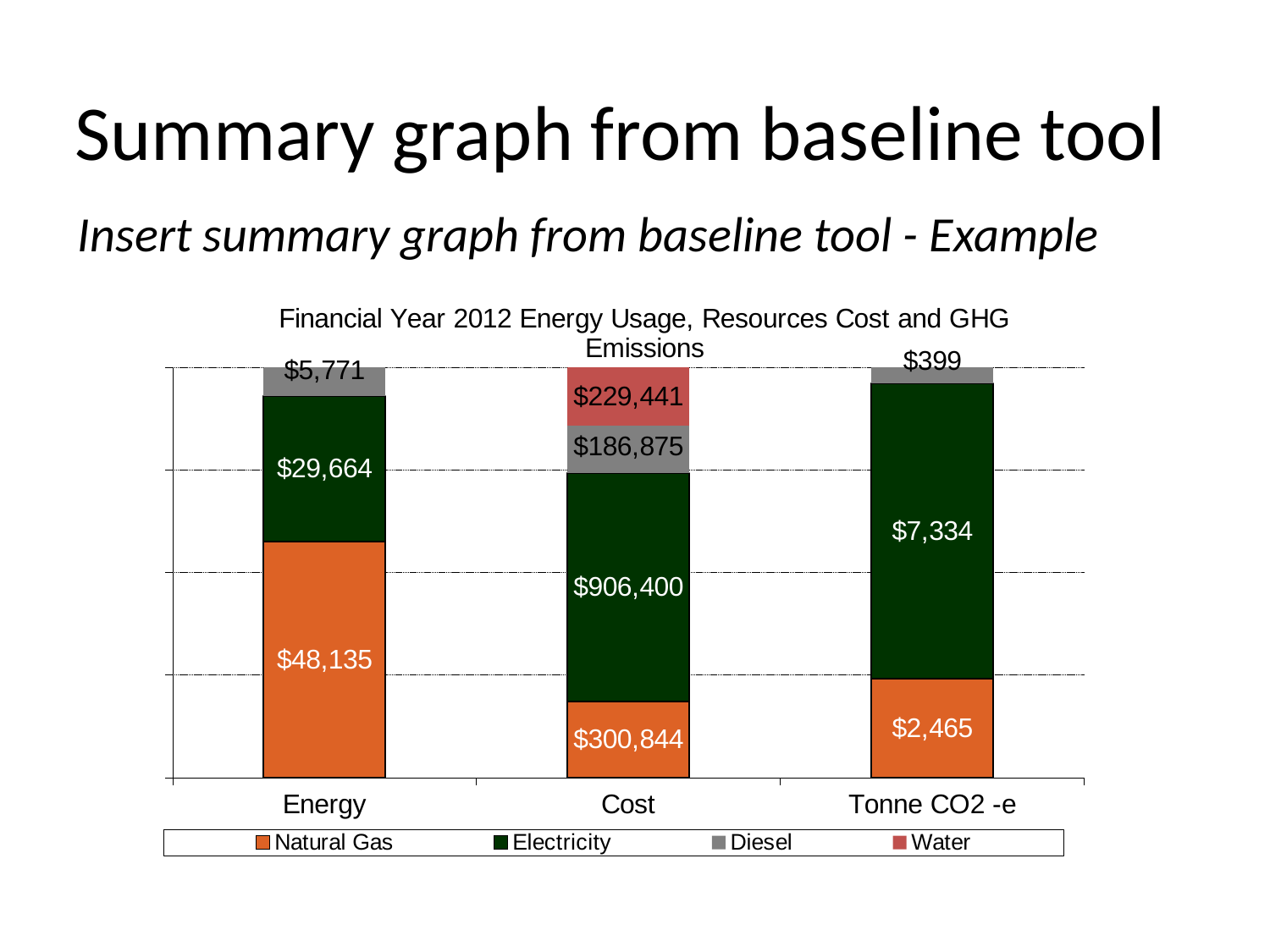
What is the Water value for the Cost bar? $229,441 In the Energy bar, which is larger, Natural Gas or Electricity? Natural Gas What is the Natural Gas value for the Energy bar? $48,135 What is the Electricity value for the Cost bar? $906,400 What kind of chart is shown on the slide? Stacked bar chart How many series does the legend list? 4 What is the Diesel value for the Tonne CO2 -e bar? $399 Which series has the smallest value in the Energy bar? Diesel What is the difference between the Electricity and Natural Gas values in the Cost bar? $605,556 What is the total of the Tonne CO2 -e bar? $10,198 How many categories are shown on the x axis? 3 Which series has the largest value in the Cost bar? Electricity